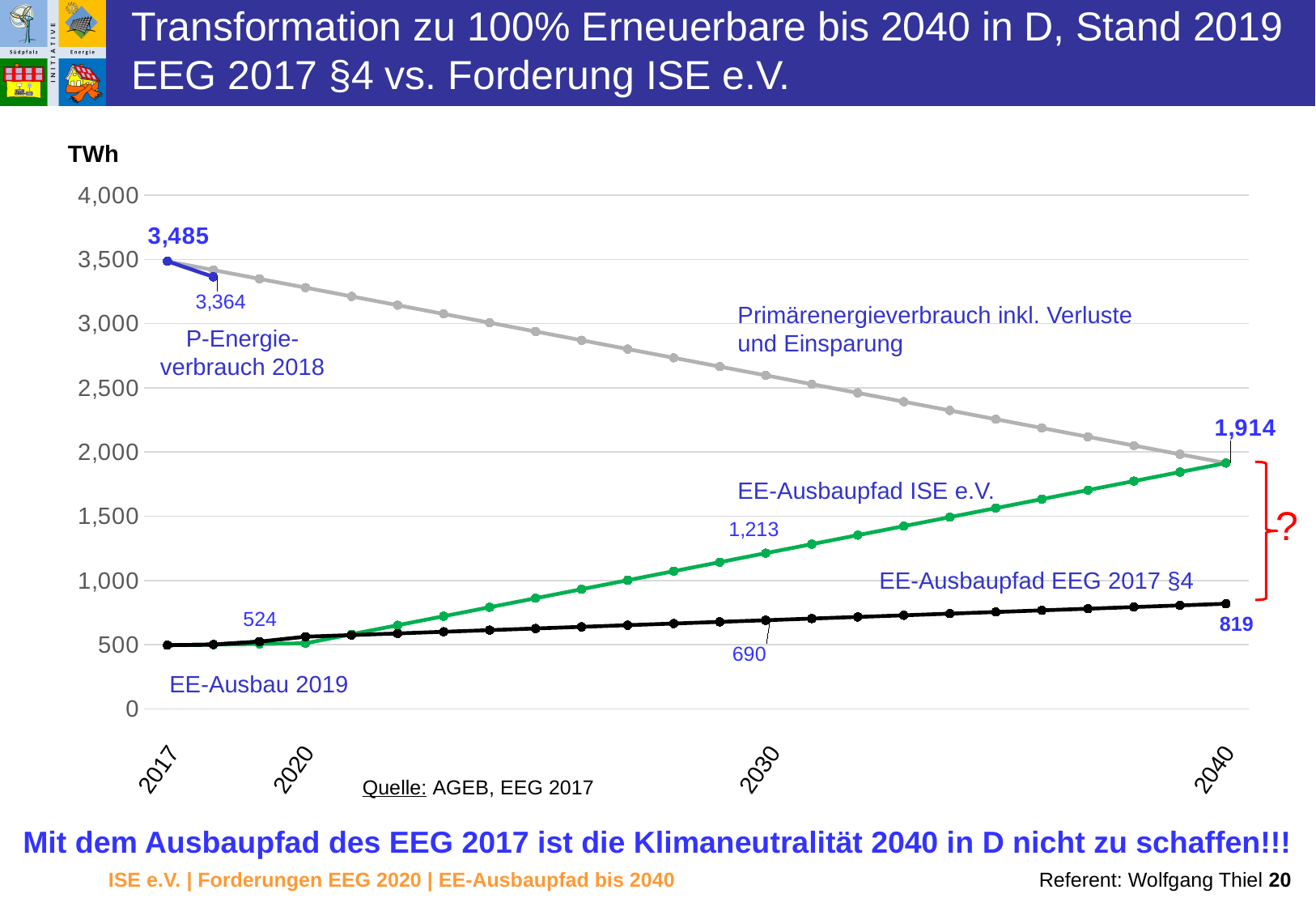
Does the Primärenergieverbrauch line rise or fall from 2017 to 2040? fall What is the difference between the 2040 values of the EE-Ausbaupfad ISE e.V. (1,914) and the EE-Ausbaupfad EEG 2017 §4 (819)? 1,095 What is the difference between the 2030 values of the EE-Ausbaupfad ISE e.V. (1,213) and the EE-Ausbaupfad EEG 2017 §4 (690)? 523 What is the labelled value for P-Energieverbrauch 2018? 3,364 What is the labelled value of the EE-Ausbaupfad ISE e.V. line in 2030? 1,213 What is the labelled value of the Primärenergieverbrauch in 2017? 3,485 What is the labelled value of the EE-Ausbaupfad EEG 2017 §4 line in 2030? 690 What unit is shown on the y axis of the chart? TWh What kind of chart is shown on the slide? line chart In 2040, which line is higher: EE-Ausbaupfad ISE e.V. or EE-Ausbaupfad EEG 2017 §4? EE-Ausbaupfad ISE e.V. What value does the EE-Ausbaupfad ISE e.V. line reach in 2040? 1,914 What value does the EE-Ausbaupfad EEG 2017 §4 line reach in 2040? 819